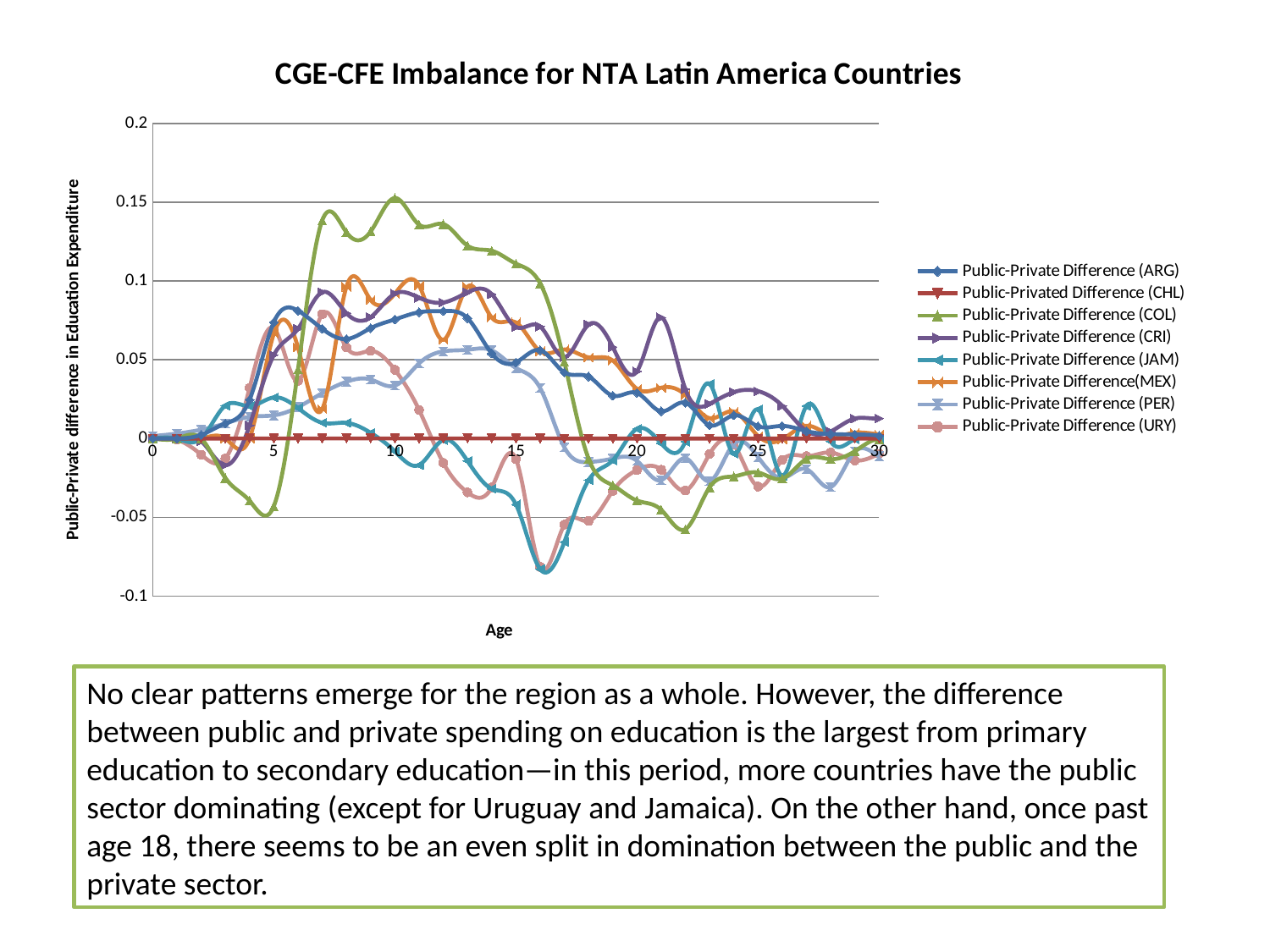
Does the Public-Privated Difference (CHL) series rise, fall, or stay flat across the age range? stays flat At age 10, which is larger: Public-Private Difference (COL) or Public-Private Difference (ARG)? Public-Private Difference (COL) What is the label of the x axis? Age What kind of chart is shown on the slide? line chart Is the value for Public-Private Difference (ARG) at age 5 greater or less than 0.05? greater Which series has the highest value at age 10? Public-Private Difference (COL) Is the value for Public-Private Difference (URY) at age 16 greater or less than -0.05? less What is the title of the chart? CGE-CFE Imbalance for NTA Latin America Countries How many series does the legend list? 8 Is the value for Public-Private Difference (COL) at age 10 greater or less than 0.1? greater Which series has the lowest value at age 5? Public-Private Difference (COL)